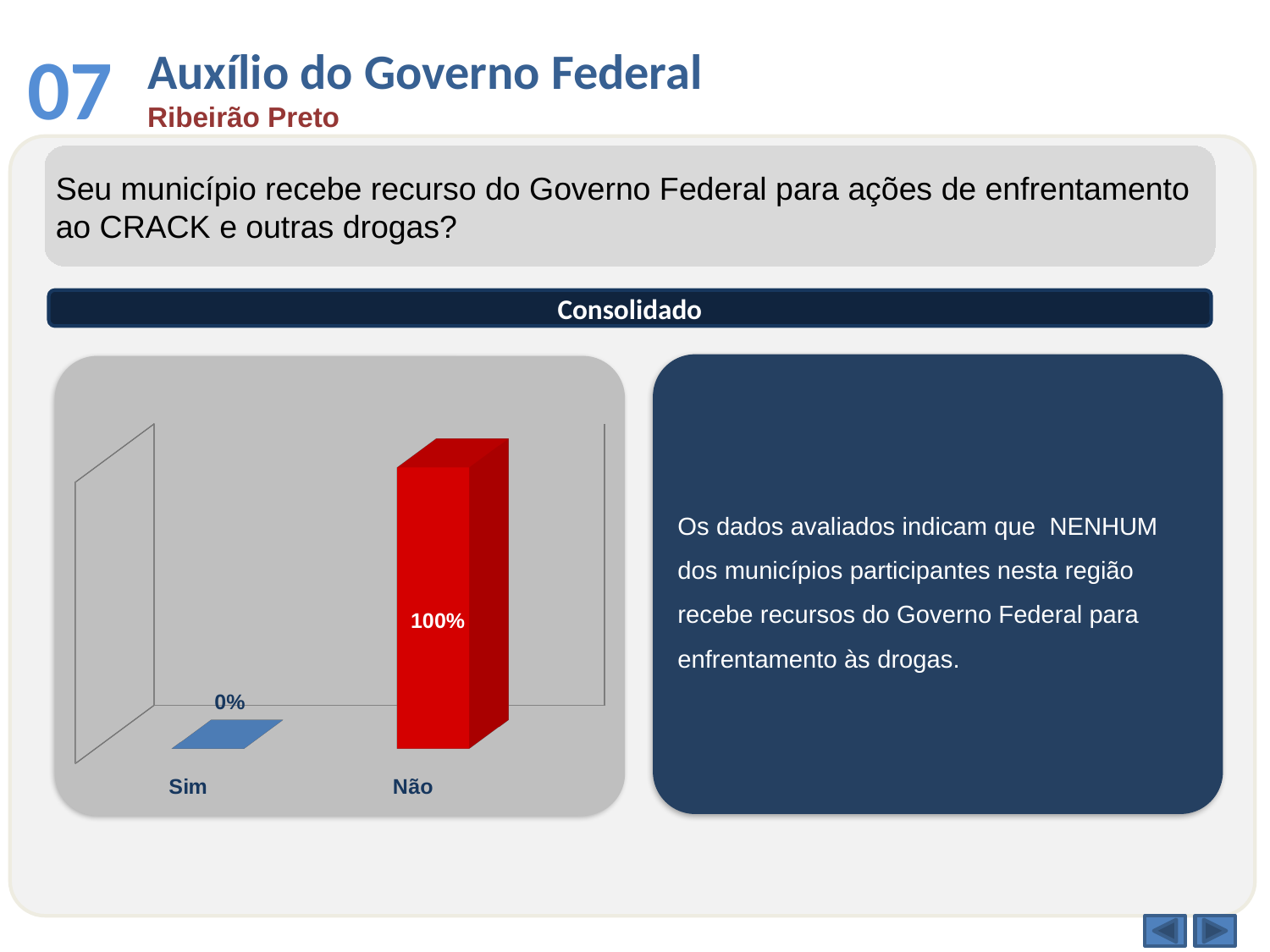
How many categories are shown on the chart? 2 What colour is the bar for Sim? blue What colour is the bar for Não? red Which is larger, the value for Sim or the value for Não? Não What is the difference between the values for Não and Sim? 100% Which category has the highest value? Não What is the value for Sim? 0% Which category has the lowest value? Sim What is the value for Não? 100% What kind of chart is shown on the slide? bar chart